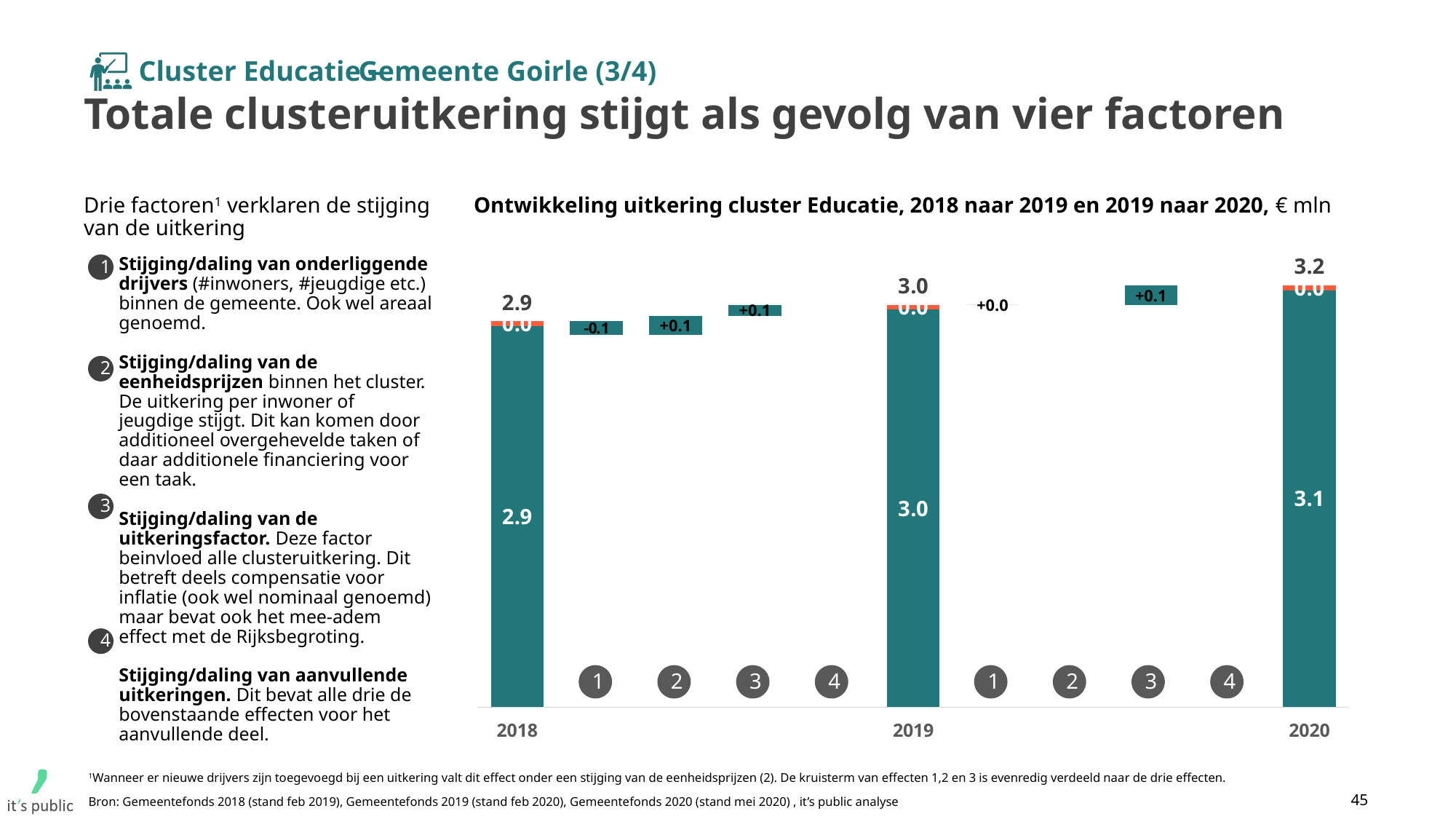
What is the value of factor 3 in the step from 2019 to 2020? +0.1 What is the value printed inside the large teal segment of the 2020 bar? 3.1 What is the total value shown above the 2019 bar? 3.0 Which year has the highest total uitkering? 2020 What is the total value shown above the 2020 bar? 3.2 What is the total value shown above the 2018 bar? 2.9 What is the value of factor 1 in the step from 2018 to 2019? -0.1 What is the value of factor 1 in the step from 2019 to 2020? +0.0 What is the difference between the 2020 total and the 2018 total? 0.3 Do the total values rise or fall from 2018 to 2020? rise Which year has the lowest total uitkering? 2018 What is the value of factor 2 in the step from 2018 to 2019? +0.1